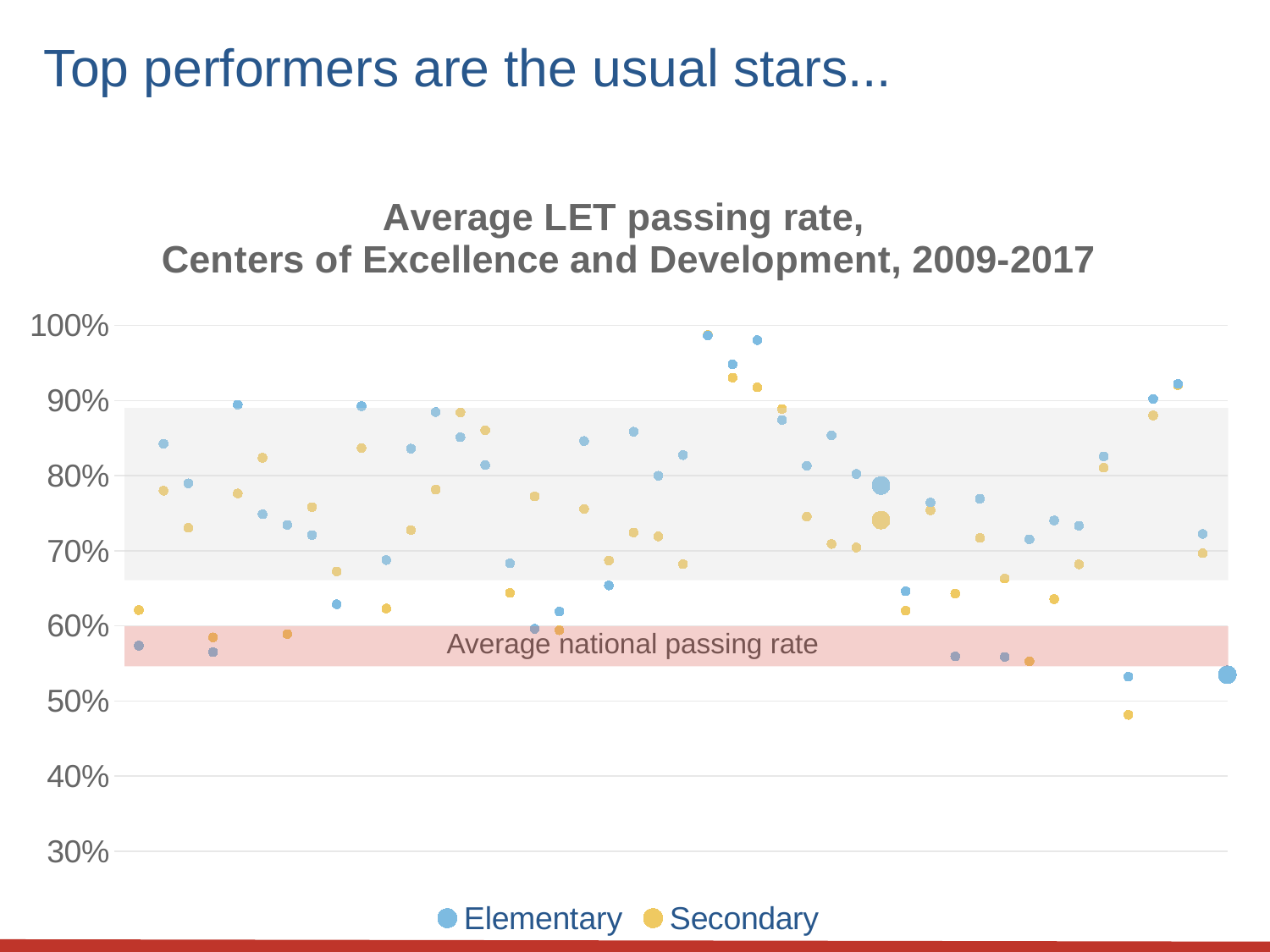
What kind of chart is shown on the slide? Scatter chart What are the two series named in the chart legend? Elementary and Secondary Is the lowest Secondary value on the chart greater or less than 50%? less What is the lowest value shown on the vertical axis? 30% What is the title of the chart? Average LET passing rate, Centers of Excellence and Development, 2009-2017 Is the highest Secondary value on the chart greater or less than 90%? greater Is the highest Elementary value on the chart greater or less than 90%? greater Which series contains the single lowest point on the chart, Elementary or Secondary? Secondary How many series does the chart legend list? 2